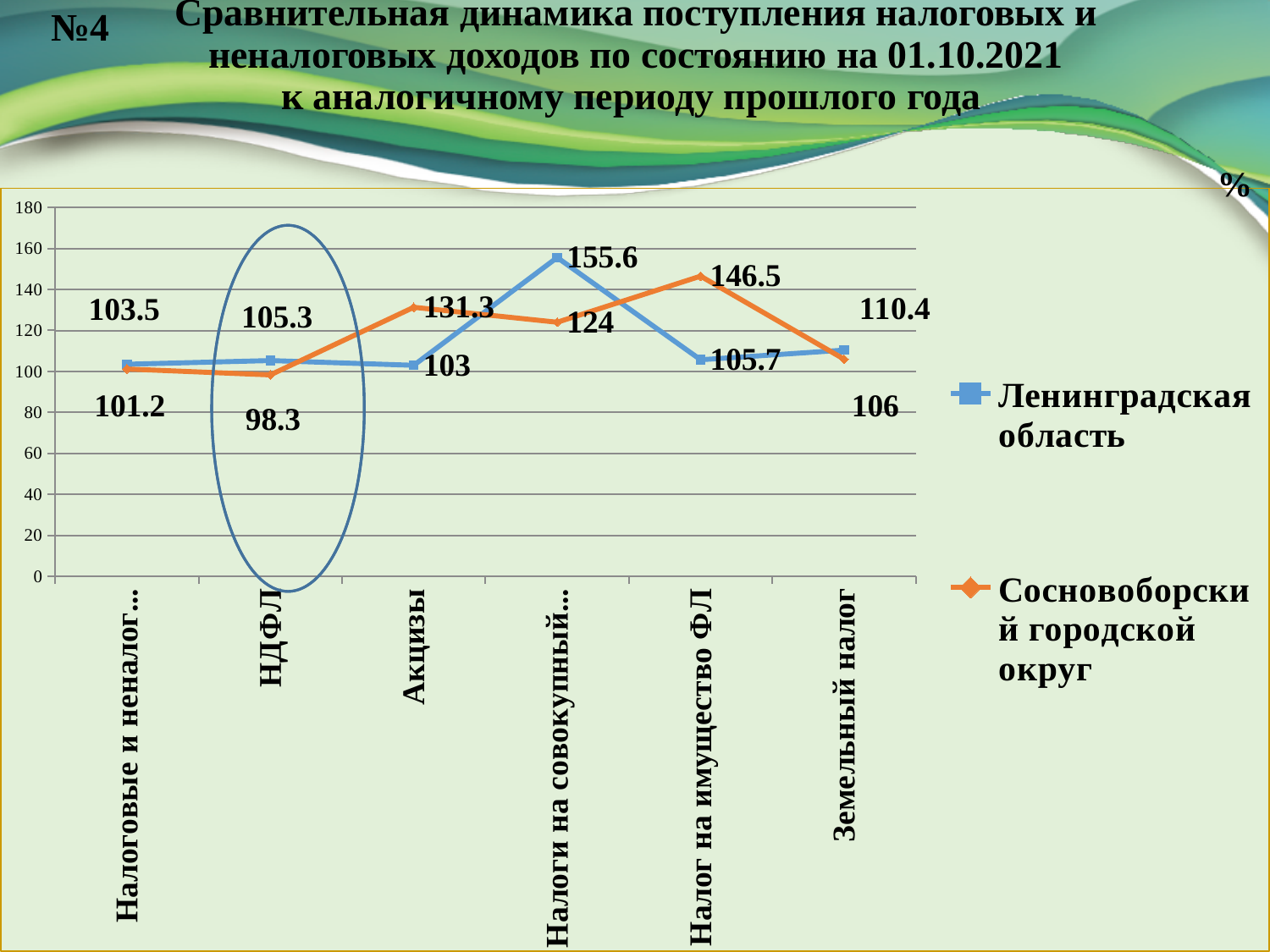
What is the value for Ленинградская область for Налог на имущество ФЛ? 105.7 What is the difference between the Сосновоборский городской округ and Ленинградская область values for Налог на имущество ФЛ? 40.8 For Земельный налог, which series has the larger value? Ленинградская область What is the value for Ленинградская область for НДФЛ? 105.3 For which category is the Ленинградская область value highest? Налоги на совокупный... How many series does the legend list? 2 Which series is drawn in orange? Сосновоборский городской округ What is the value for Сосновоборский городской округ for НДФЛ? 98.3 What kind of chart is shown on the slide? line chart How many categories are shown on the x axis? 6 For which category is the Сосновоборский городской округ value lowest? НДФЛ What is the value for Сосновоборский городской округ for Акцизы? 131.3